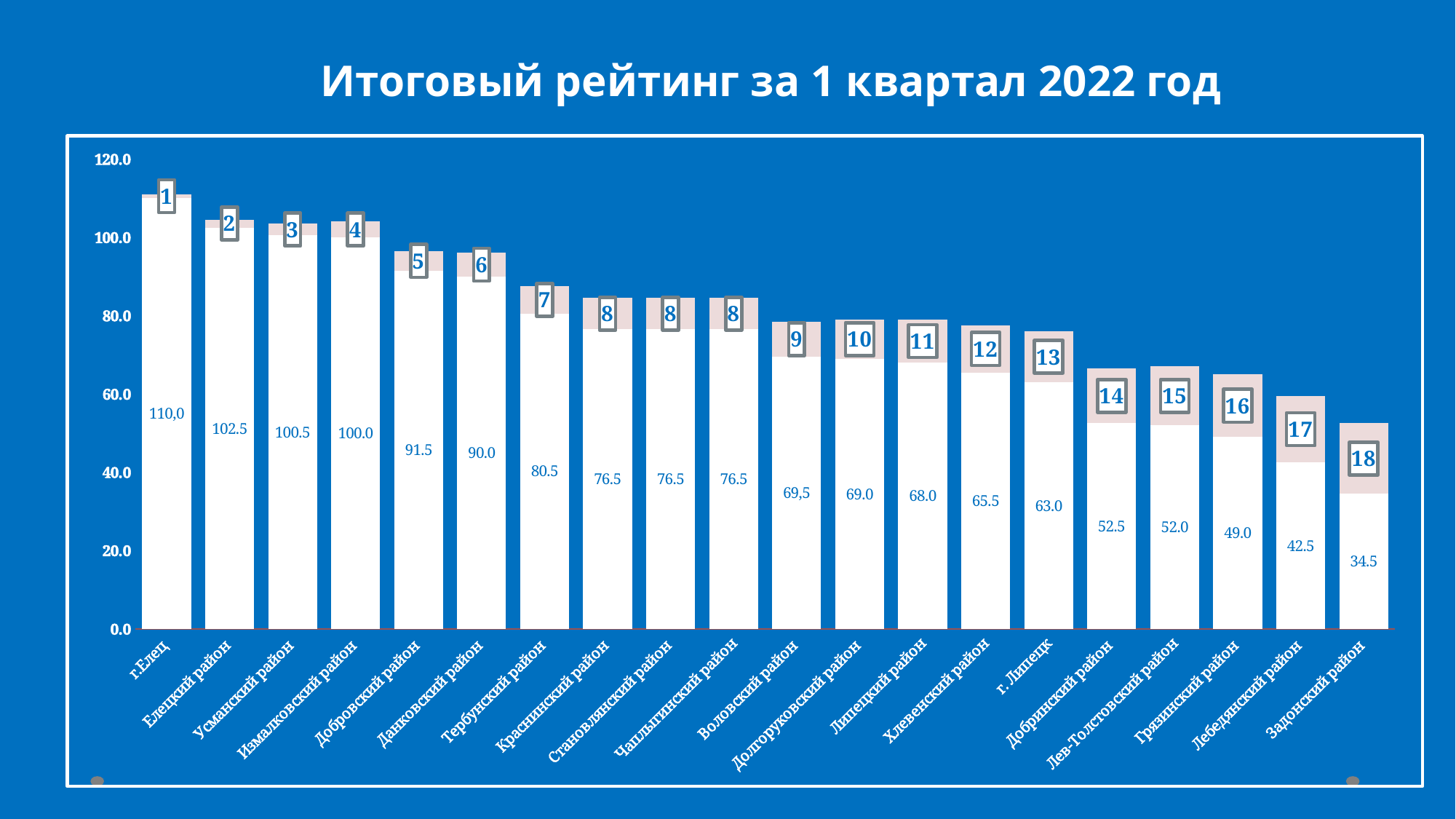
Is the value for Лебедянский район greater or less than 60.0? less What is the value for г. Липецк? 63.0 Which category has the lowest value? Задонский район What is the value for Задонский район? 34.5 What kind of chart is shown on the slide? bar chart What is the difference between the values for Елецкий район and Усманский район? 2.0 What is the value for Добровский район? 91.5 What is the value for г.Елец? 110,0 Which is larger, the value for Тербунский район or the value for Воловский район? Тербунский район What is the title of the chart? Итоговый рейтинг за 1 квартал 2022 год How many categories are shown on the x axis? 20 Which category has the highest value? г.Елец